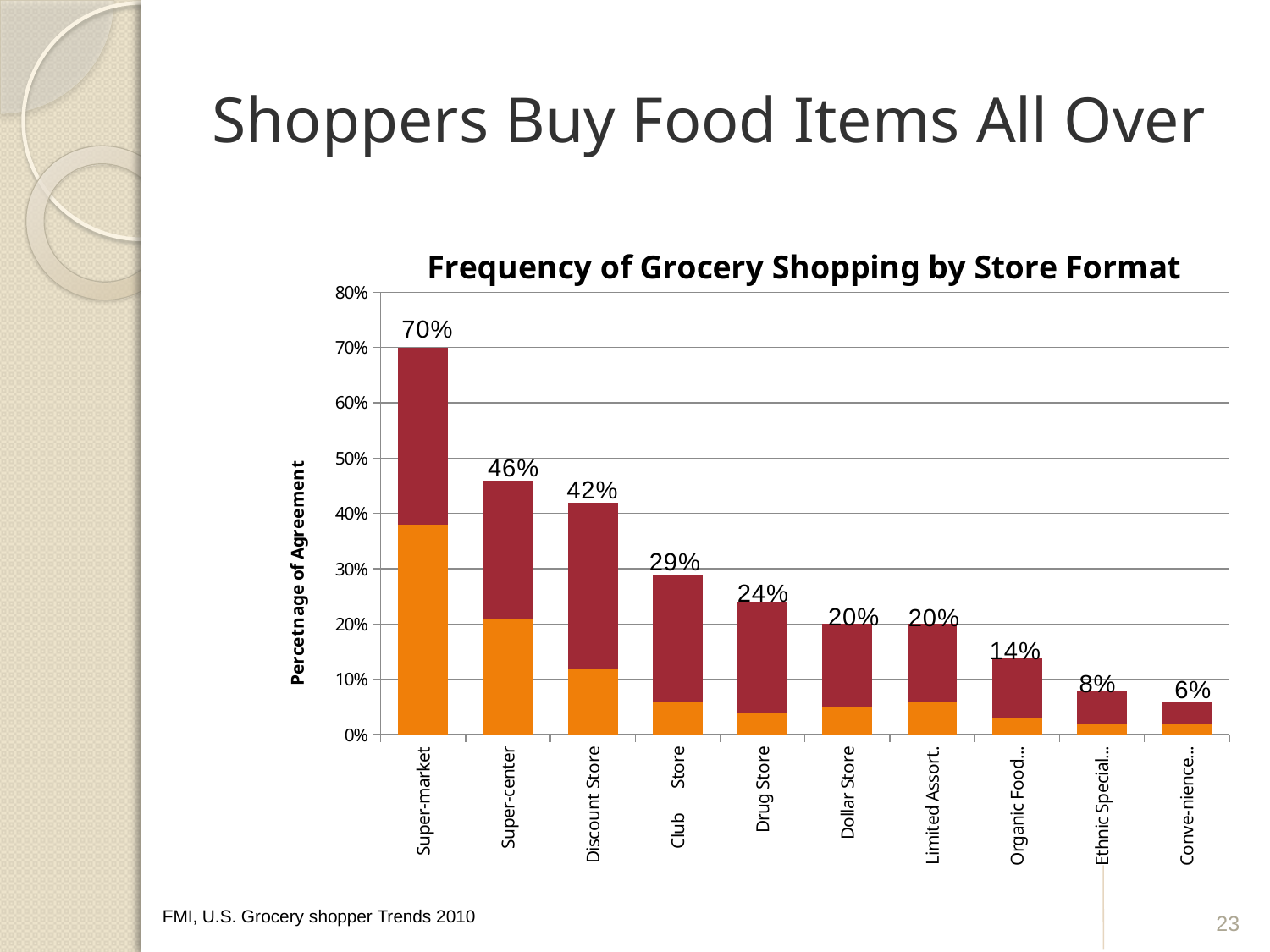
Do the total values rise or fall moving from left to right along the x axis? Fall How many store formats are shown on the x axis? 10 What is the title of the chart? Frequency of Grocery Shopping by Store Format What is the total value shown for Club Store? 29% Is the orange segment for Super-market greater or less than 30%? greater What is the difference between the total values for Super-center and Discount Store? 4% What kind of chart is shown on the slide? Stacked bar chart Which has a larger total value, Drug Store or Dollar Store? Drug Store Which store format has the highest total value? Super-market Which store format has the lowest total value? Conve-nience What is the total value shown for Super-market? 70% What is the total value shown for Organic Food? 14%